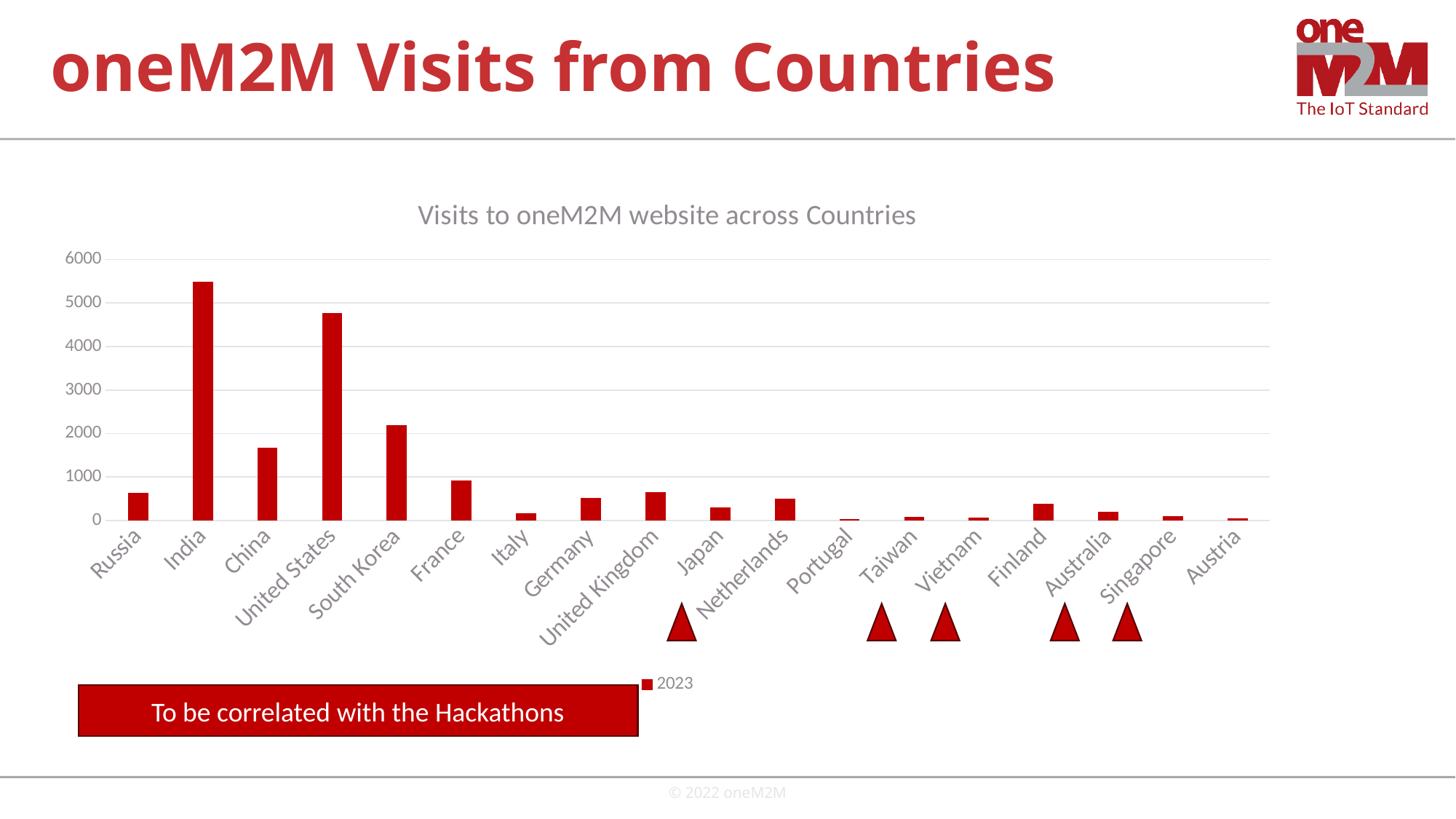
What is the title of the chart? Visits to oneM2M website across Countries What type of chart is shown on the slide? bar chart Is the value for United States greater or less than 4000? greater Is the value for India greater or less than 5000? greater Is the value for China greater or less than 2000? less Which has more visits, India or United States? India What year does the legend entry of the chart show? 2023 Which has more visits, China or South Korea? South Korea How many series does the chart legend list? 1 Which country has the highest number of visits in the chart? India How many countries are shown on the x axis of the chart? 18